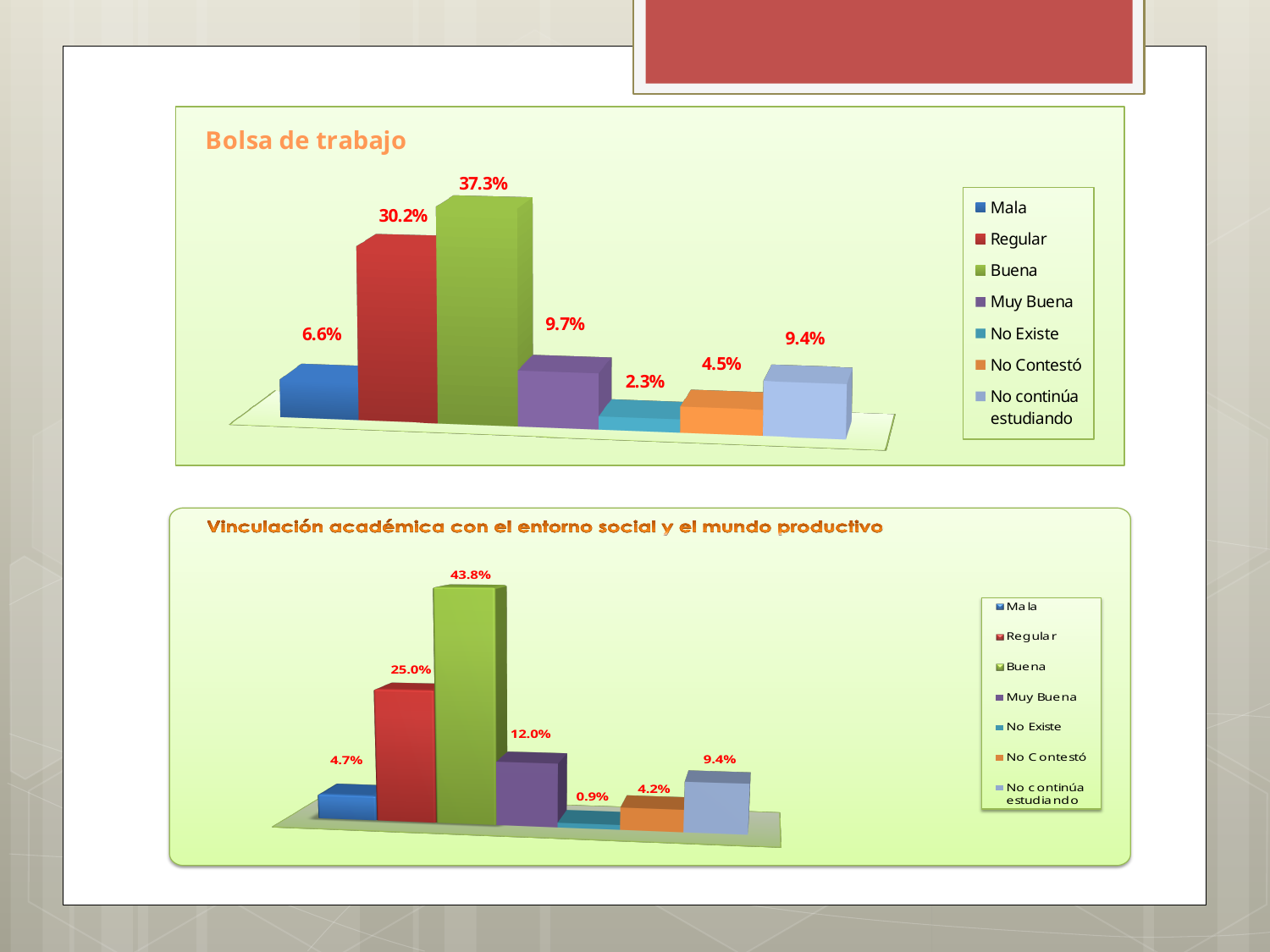
In the 'Bolsa de trabajo' chart, which category has the highest value? Buena In the 'Vinculación académica con el entorno social y el mundo productivo' chart, which is larger, Mala or No Contestó? Mala In the 'Bolsa de trabajo' chart, what is the value for Buena? 37.3% In the 'Bolsa de trabajo' chart, how many categories does the legend list? 7 In the 'Vinculación académica con el entorno social y el mundo productivo' chart, what is the value for Muy Buena? 12.0% In the 'Vinculación académica con el entorno social y el mundo productivo' chart, what is the difference between Regular and Muy Buena? 13.0% In the 'Bolsa de trabajo' chart, what is the value for No Existe? 2.3% In the 'Vinculación académica con el entorno social y el mundo productivo' chart, which category has the lowest value? No Existe In the 'Vinculación académica con el entorno social y el mundo productivo' chart, what is the value for Buena? 43.8% In the 'Bolsa de trabajo' chart, which category has the lowest value? No Existe In the 'Bolsa de trabajo' chart, what is the difference between Buena and Regular? 7.1% What kind of chart is the 'Bolsa de trabajo' chart? Bar chart